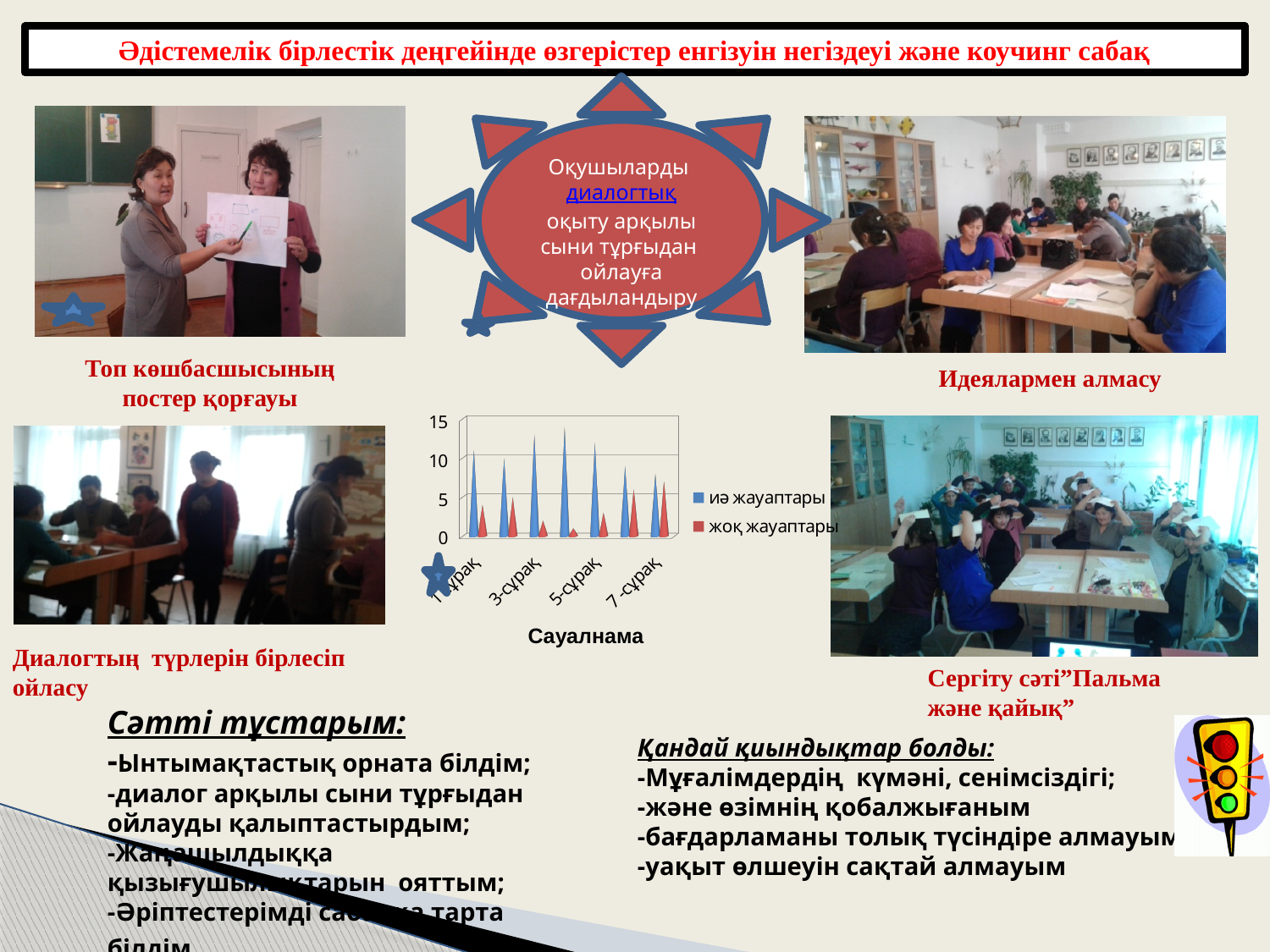
What kind of chart is shown on the slide? bar chart Is the value of жоқ жауаптары for 5-сұрақ greater or less than 5? less What are the two series named in the chart legend? иә жауаптары and жоқ жауаптары Is the value of иә жауаптары for 5-сұрақ greater or less than 10? greater How many series does the legend of the chart list? 2 For 3-сұрақ, which series has the larger value, иә жауаптары or жоқ жауаптары? иә жауаптары Is the value of иә жауаптары for 3-сұрақ greater or less than 5? greater What is the caption/title shown under the chart? Сауалнама What is the highest value shown on the chart's vertical axis? 15